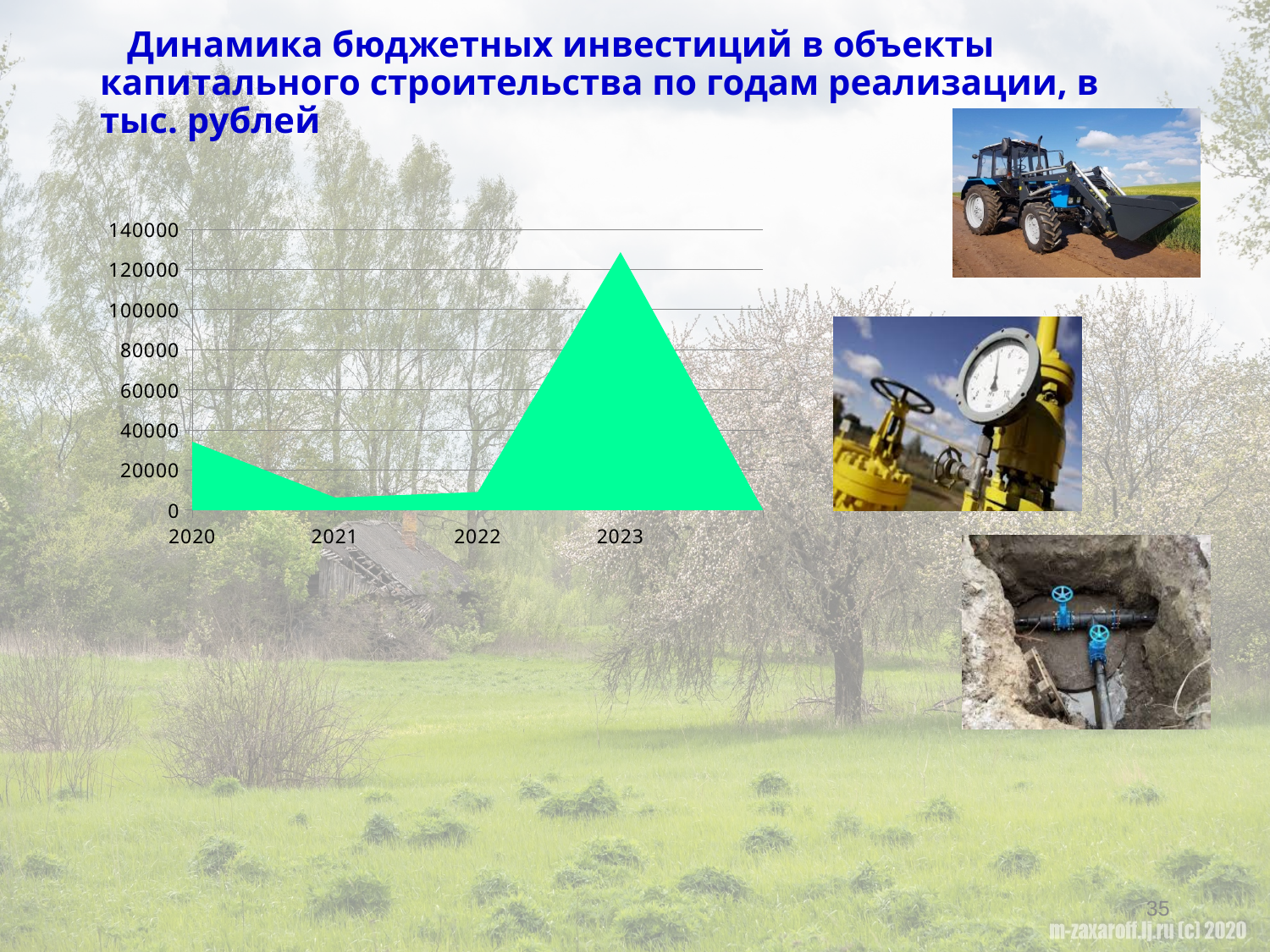
How many years are labeled on the x axis of the chart? 4 What kind of chart is shown on the slide? area chart Is the value for 2020 greater or less than 20000? greater What is the highest tick value shown on the y axis? 140000 Is the value for 2020 greater or less than 40000? less Which is larger, the value for 2020 or the value for 2021? 2020 Which is larger, the value for 2023 or the value for 2020? 2023 Is the value for 2023 greater or less than 120000? greater Which year has the highest value of budget investments? 2023 Do the values rise or fall from 2022 to 2023? rise